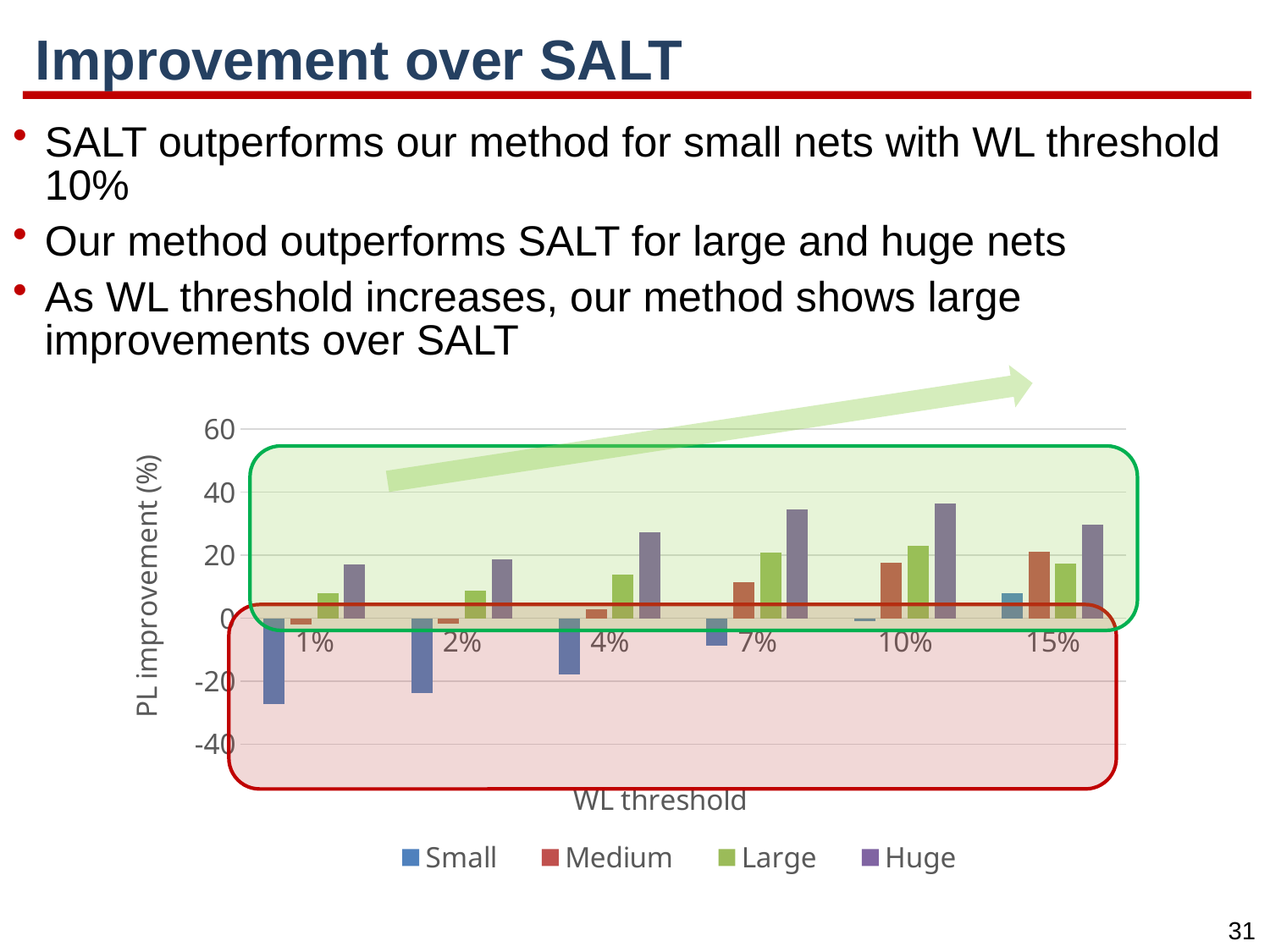
What is the title of the y axis? PL improvement (%) Which series has the highest value at the 10% WL threshold? Huge Is the value for Huge at the 10% WL threshold greater or less than 20? greater Is the value for Small at the 1% WL threshold greater or less than -20? less Does the Small series rise or fall as the WL threshold increases from 1% to 15%? rise How many WL threshold categories are shown on the x axis? 6 What kind of chart is shown on the slide? bar chart At the 15% WL threshold, which is larger, the Huge value or the Large value? Huge Is the value for Huge at the 1% WL threshold greater or less than 20? less What is the title of the x axis? WL threshold How many series does the chart legend list? 4 Which series has the lowest value at the 1% WL threshold? Small